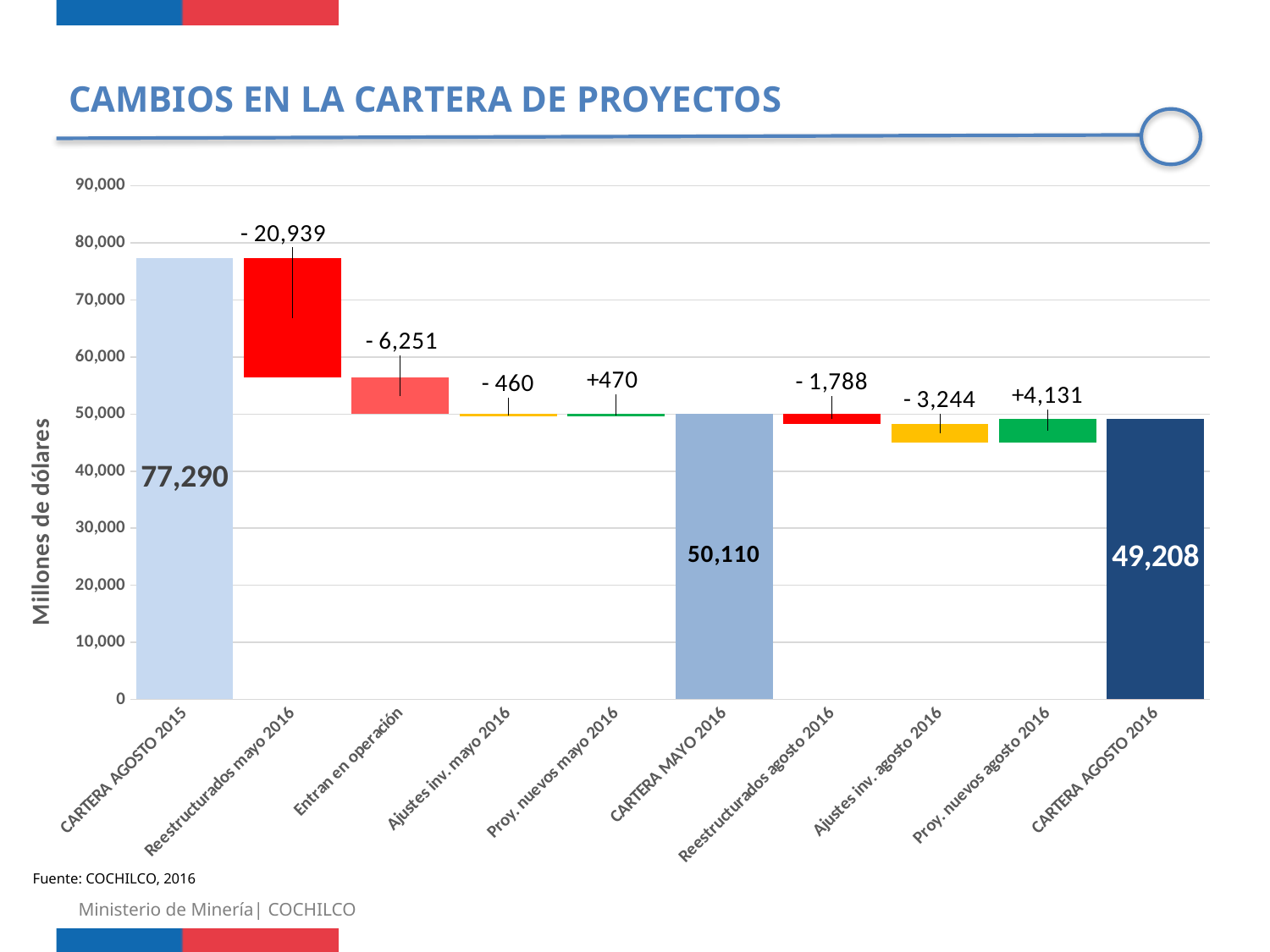
Which category has the highest bar? CARTERA AGOSTO 2015 What is the title of the chart? CAMBIOS EN LA CARTERA DE PROYECTOS How many categories are shown on the x axis? 10 What is the value shown for CARTERA MAYO 2016? 50,110 What change is labelled for Reestructurados mayo 2016? - 20,939 Which is larger, the change for Ajustes inv. agosto 2016 or the change for Reestructurados agosto 2016 (in absolute size)? Ajustes inv. agosto 2016 What is the value shown for CARTERA AGOSTO 2015? 77,290 What is the value shown for CARTERA AGOSTO 2016? 49,208 What change is labelled for Proy. nuevos agosto 2016? +4,131 What is the difference between CARTERA MAYO 2016 and CARTERA AGOSTO 2016? 902 What change is labelled for Entran en operación? - 6,251 What is the difference between CARTERA AGOSTO 2015 and CARTERA MAYO 2016? 27,180